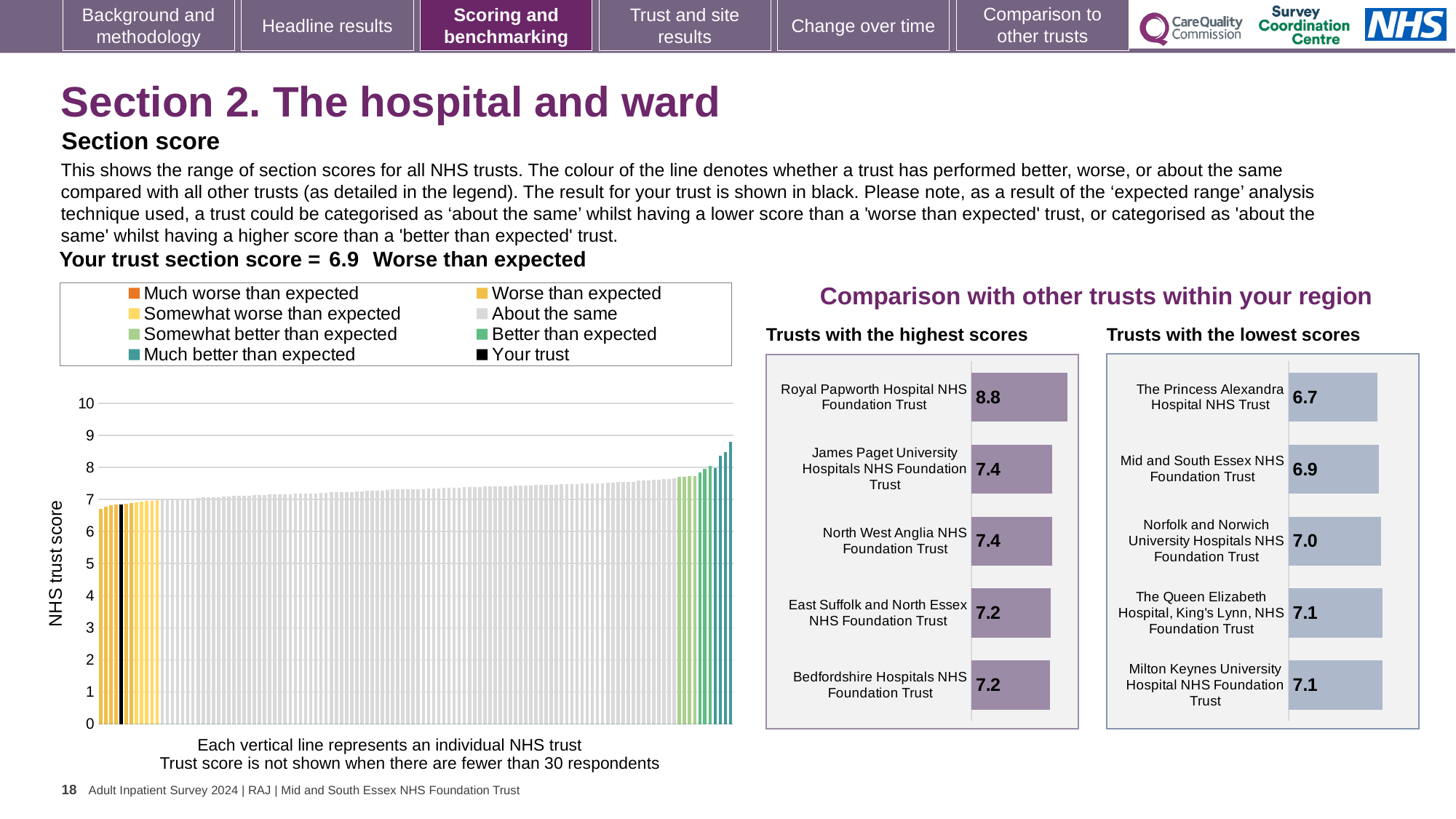
In the 'Trusts with the lowest scores' chart, what is the score for The Princess Alexandra Hospital NHS Trust? 6.7 In the 'Trusts with the lowest scores' chart, what is the difference between the scores of Milton Keynes University Hospital NHS Foundation Trust and The Princess Alexandra Hospital NHS Trust? 0.4 In the 'Trusts with the lowest scores' chart, which trust has the lowest score? The Princess Alexandra Hospital NHS Trust In the 'Trusts with the highest scores' chart, which trust has the highest score? Royal Papworth Hospital NHS Foundation Trust In the large chart on the left, is the value of the tallest bar greater or less than 8? greater In the 'Trusts with the lowest scores' chart, which has the higher score: Norfolk and Norwich University Hospitals NHS Foundation Trust or Mid and South Essex NHS Foundation Trust? Norfolk and Norwich University Hospitals NHS Foundation Trust In the 'Trusts with the highest scores' chart, what is the difference between the scores of Royal Papworth Hospital NHS Foundation Trust and James Paget University Hospitals NHS Foundation Trust? 1.4 What kind of chart is the large chart on the left showing NHS trust scores? Bar chart How many trusts are shown in the 'Trusts with the highest scores' chart? 5 How many trusts are shown in the 'Trusts with the lowest scores' chart? 5 How many entries does the legend of the large chart on the left list? 8 In the 'Trusts with the highest scores' chart, what is the score for Royal Papworth Hospital NHS Foundation Trust? 8.8